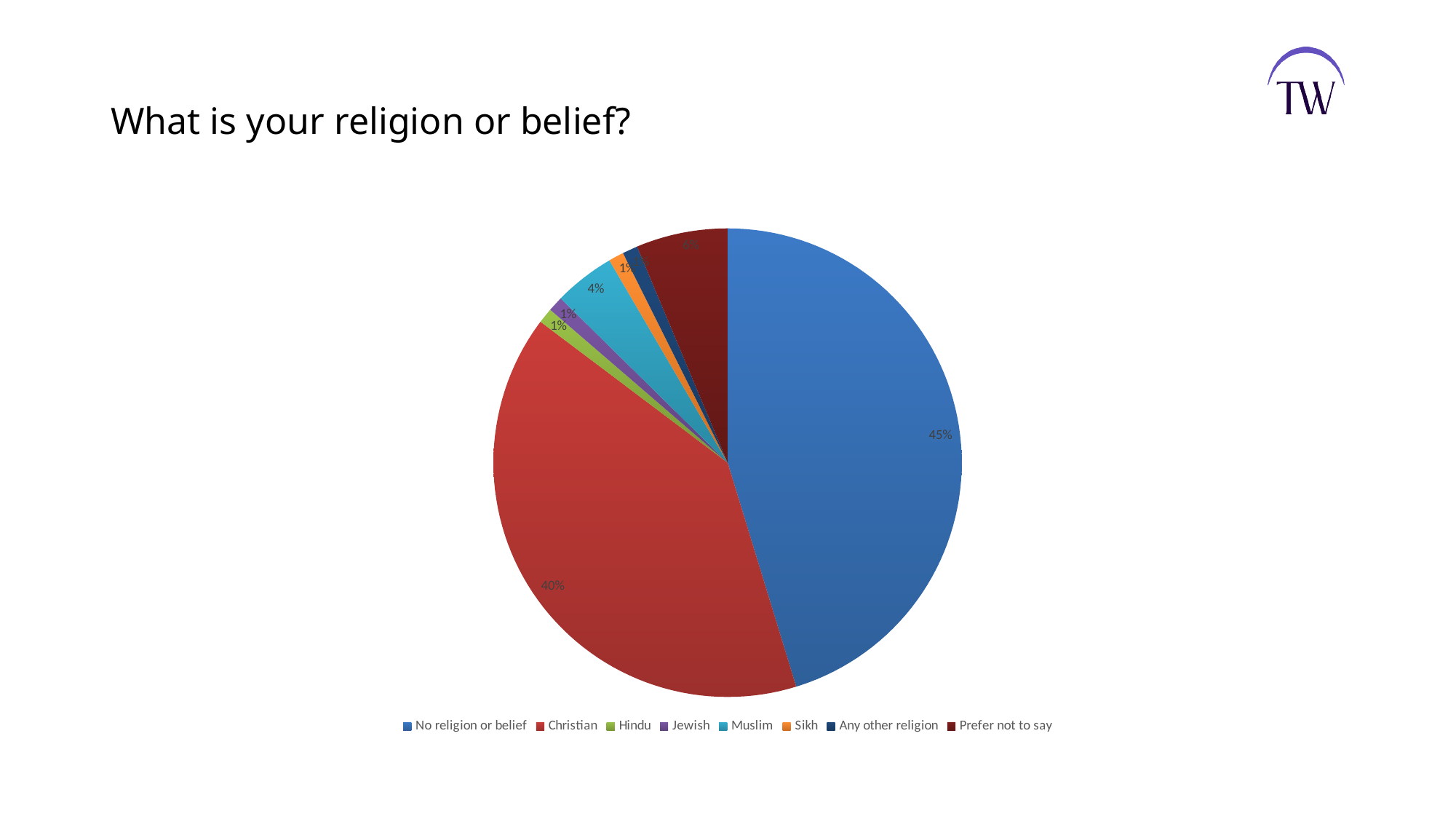
Which is larger, the Christian slice or the Muslim slice? Christian How many categories does the legend list? 8 What percentage of respondents are Christian? 40% What share of respondents answered "No religion or belief"? 45% What percentage of respondents are Jewish? 1% What percentage of respondents are Muslim? 4% What is the difference in percentage points between "No religion or belief" and "Christian"? 5% Which category has the largest slice of the pie? No religion or belief What percentage of respondents are Hindu? 1% What kind of chart is shown on the slide? Pie chart What is the title of the slide? What is your religion or belief? What percentage of respondents are Sikh? 1%